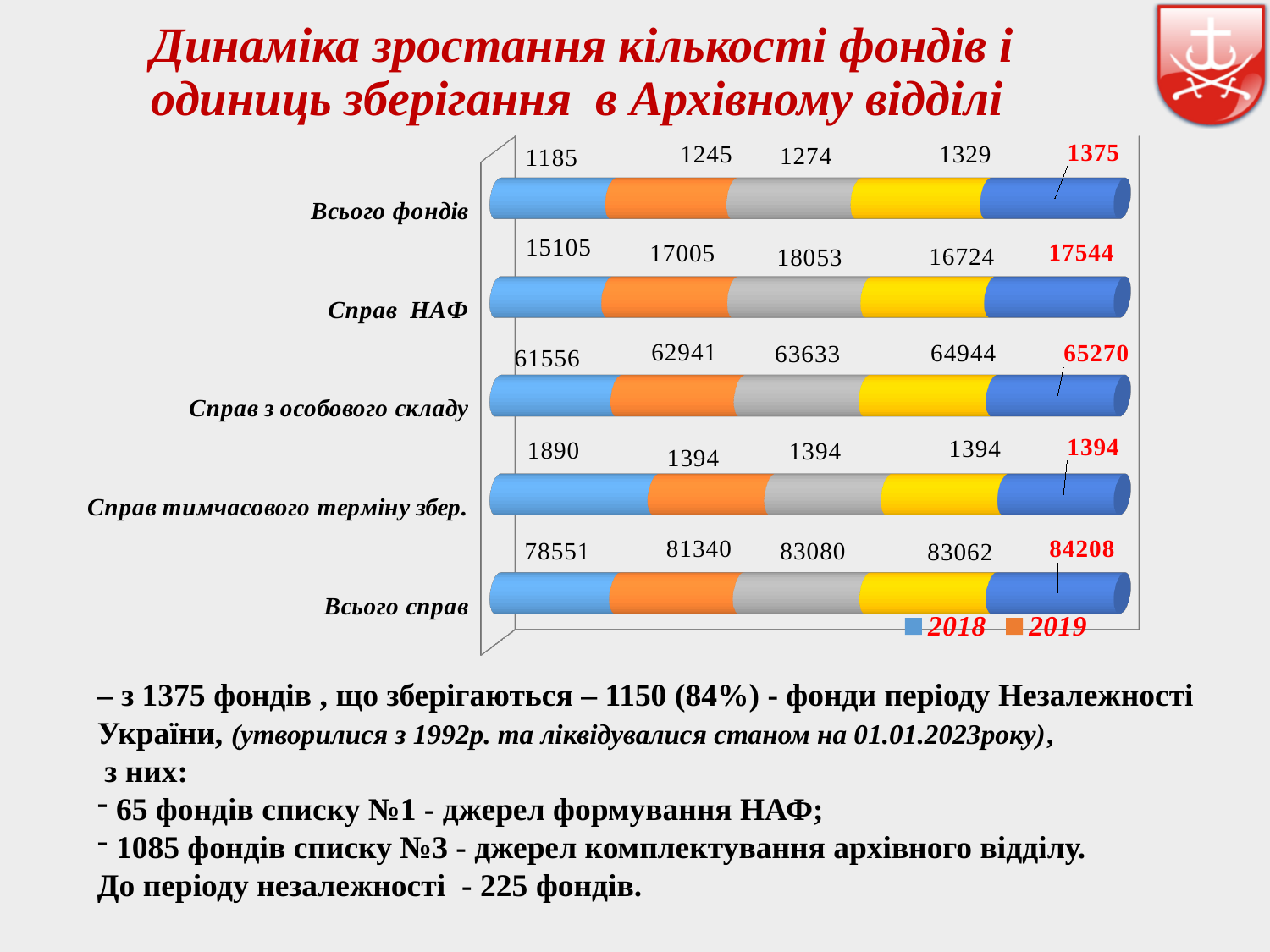
What kind of chart is shown on the slide? Stacked bar chart What is the difference between the 2019 and 2018 values for "Всього справ"? 2789 Which category has the highest 2018 value? Всього справ What is the 2019 value for "Справ НАФ"? 17005 What is the total of all segments in the "Всього фондів" bar? 6408 What is the 2018 value for "Всього фондів"? 1185 What is the value printed in red for "Всього справ"? 84208 Do the values for "Всього фондів" rise or fall from the first segment to the last segment of the bar? Rise How many categories are plotted on the vertical axis of the chart? 5 What is the 2018 value for "Справ тимчасового терміну збер."? 1890 By how much does the 2019 value for "Всього фондів" exceed the 2018 value? 60 For "Справ НАФ", which is larger: the 2018 value or the 2019 value? 2019